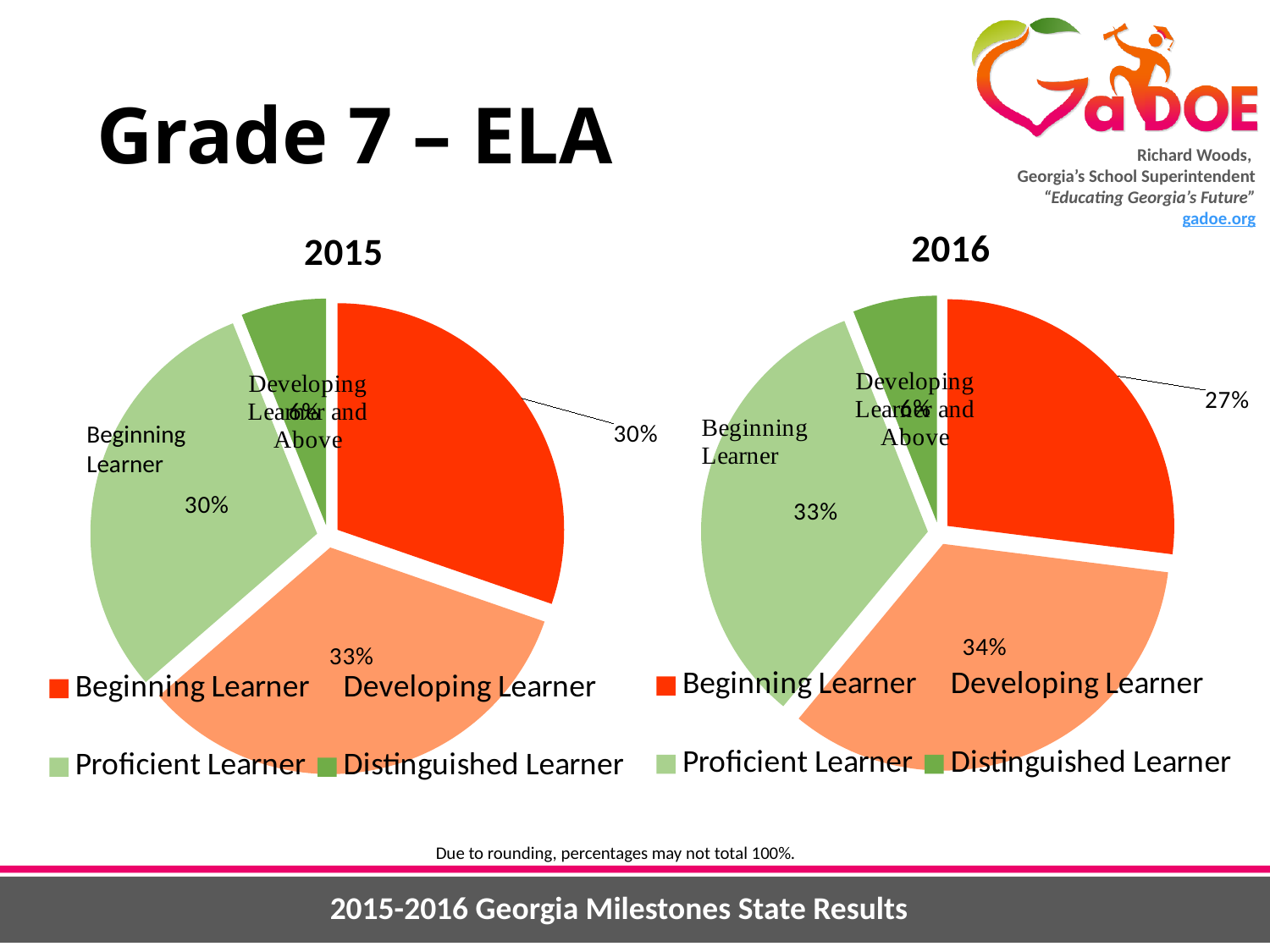
In the 2015 pie chart, what percentage is shown for Developing Learner? 33% In the 2015 pie chart, which category has the largest slice? Developing Learner In the 2015 pie chart, what percentage is shown for Beginning Learner? 30% How many slices does the 2016 pie chart have? 4 Is the Beginning Learner share larger in the 2015 chart or the 2016 chart? 2015 How many entries does the legend of the 2015 chart list? 4 In the 2016 pie chart, what percentage is shown for Beginning Learner? 27% In the 2016 pie chart, what percentage is shown for Developing Learner? 34% What type of chart is used to show the 2015 results? Pie chart In the 2016 pie chart, which category has the smallest slice? Distinguished Learner In the 2015 pie chart, what is the difference in percentage points between Developing Learner and Beginning Learner? 3 percentage points In the 2016 pie chart, what percentage is shown for Proficient Learner? 33%